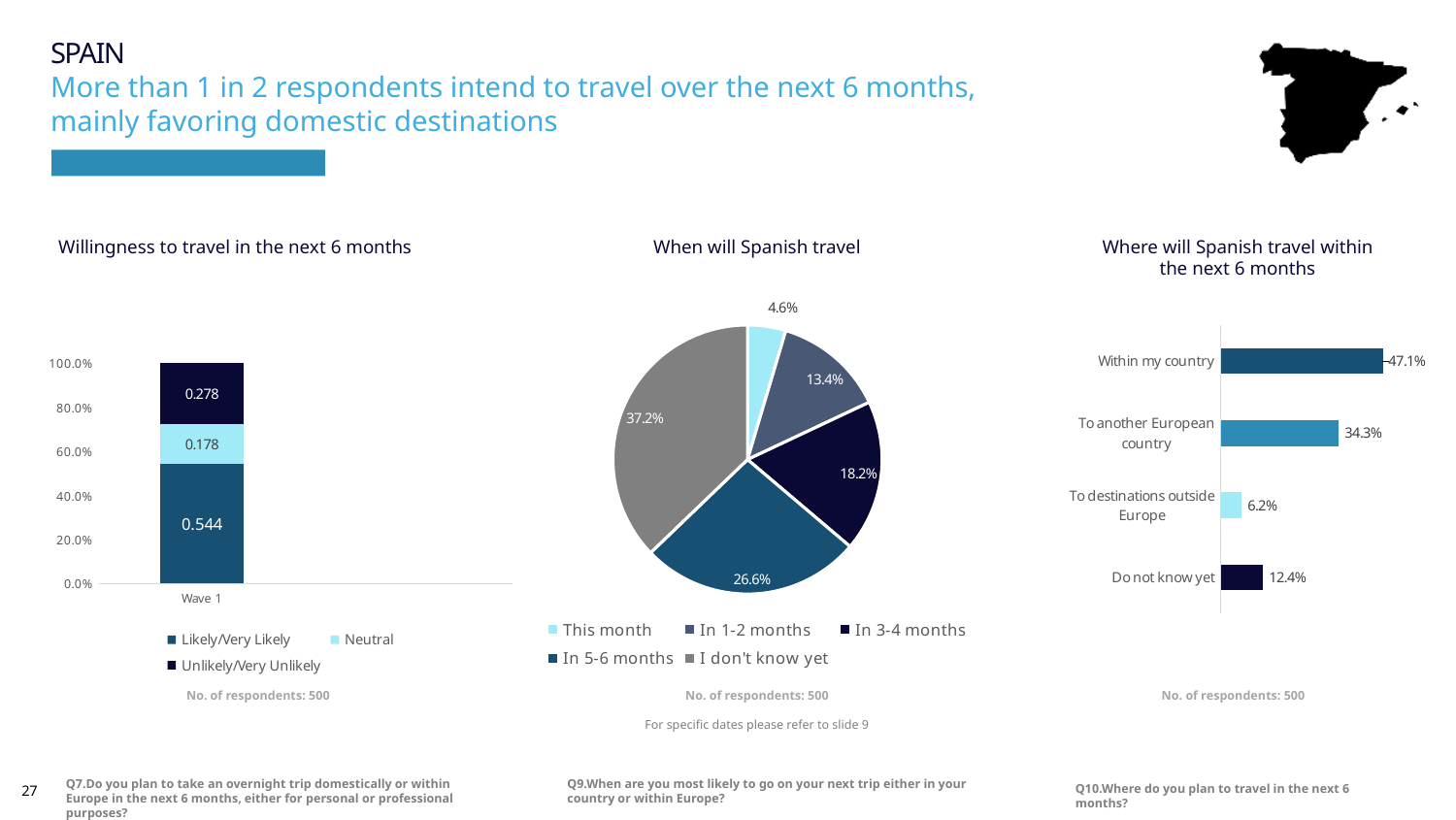
In the 'Where will Spanish travel within the next 6 months' chart, which category has the highest value? Within my country In the 'When will Spanish travel' chart, what share of the pie is 'I don't know yet'? 37.2% In the 'Willingness to travel in the next 6 months' chart, what is the value for Neutral? 0.178 In the 'Willingness to travel in the next 6 months' chart, how many series does the legend list? 3 In the 'Where will Spanish travel within the next 6 months' chart, how many categories are shown? 4 In the 'When will Spanish travel' chart, which slice is the smallest? This month In the 'Willingness to travel in the next 6 months' chart, what is the value for Likely/Very Likely in Wave 1? 0.544 What kind of chart is 'When will Spanish travel'? Pie chart In the 'When will Spanish travel' chart, what is the difference between 'In 5-6 months' and 'In 1-2 months'? 13.2% In the 'Where will Spanish travel within the next 6 months' chart, what is the value for 'To destinations outside Europe'? 6.2% In the 'When will Spanish travel' chart, what is the value for 'In 3-4 months'? 18.2% In the 'Willingness to travel in the next 6 months' chart, what is the total of the stacked bar for Wave 1? 1.000